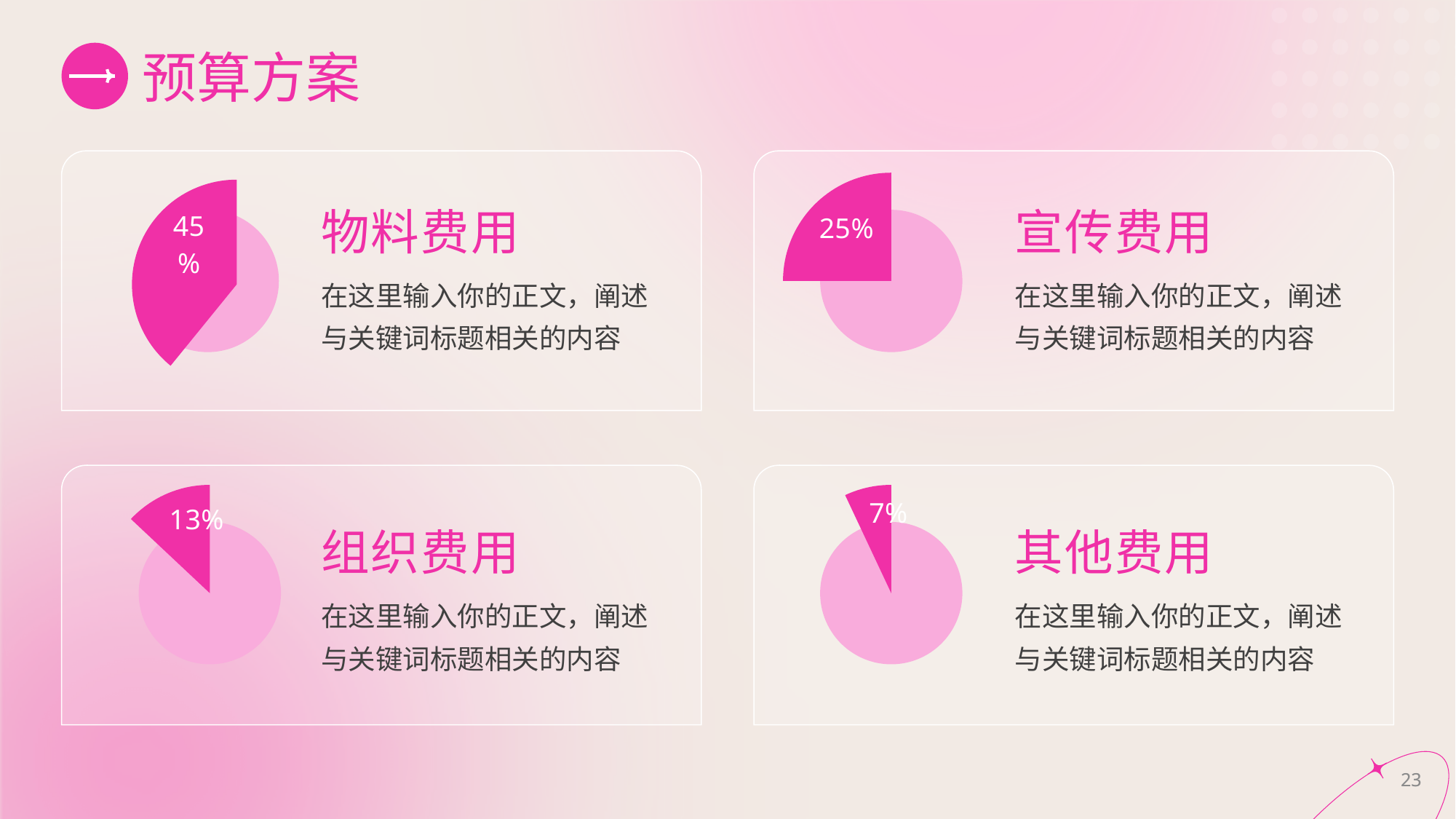
What percentage is shown on the pie chart for 其他费用? 7% What kind of chart is used for each of the four cost categories on the slide? Pie chart What is the difference between the percentage for 组织费用 and the percentage for 其他费用? 6% Which is larger, the percentage for 宣传费用 or the percentage for 组织费用? 宣传费用 Across the four pie charts on the slide, which category has the highest percentage? 物料费用 How many pie charts are shown on the slide? 4 What is the title of the slide containing the four pie charts? 预算方案 What percentage is shown on the pie chart for 物料费用? 45% What is the difference between the percentage for 物料费用 and the percentage for 宣传费用? 20% What percentage is shown on the pie chart for 组织费用? 13% Across the four pie charts on the slide, which category has the lowest percentage? 其他费用 What percentage is shown on the pie chart for 宣传费用? 25%